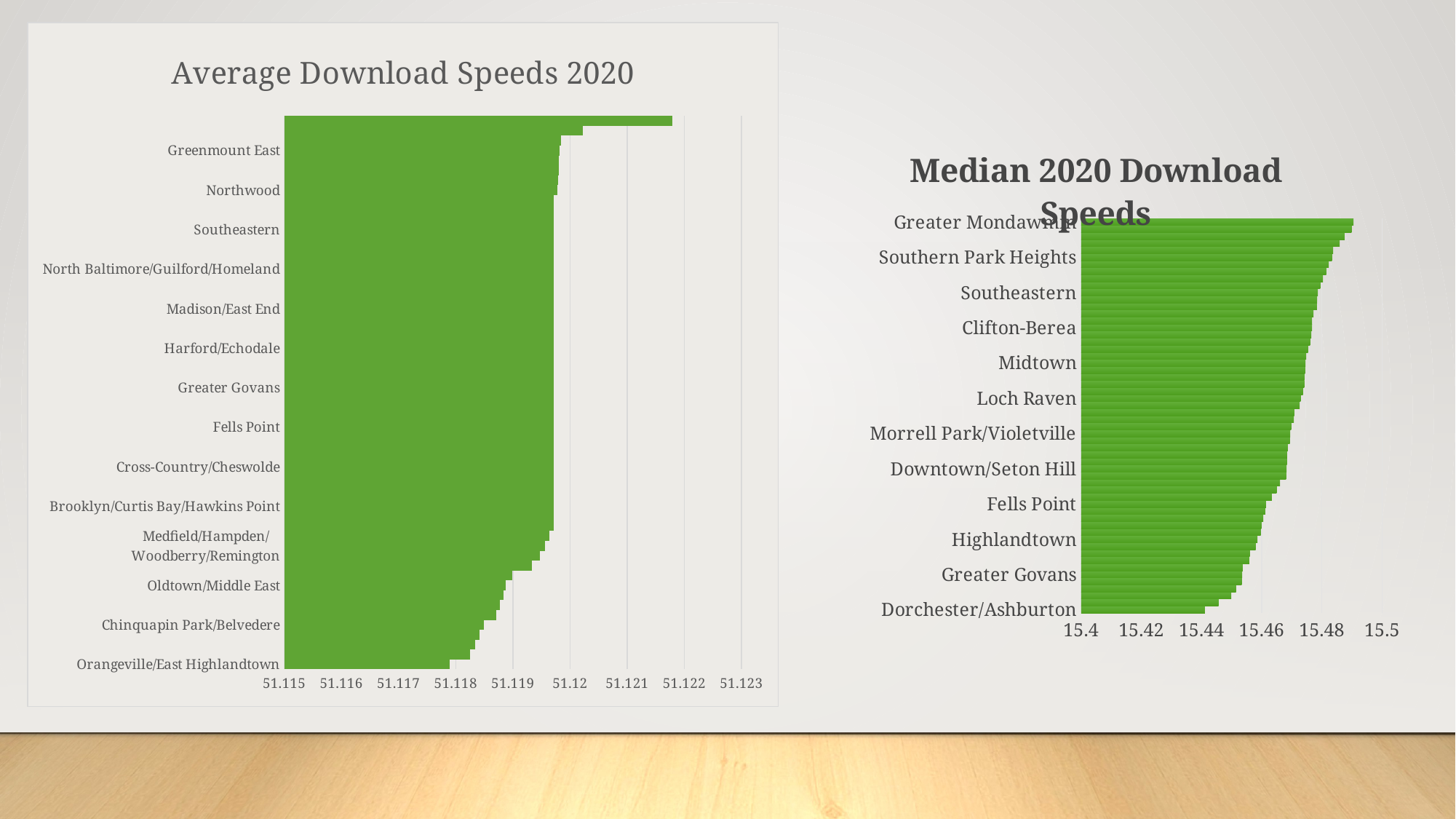
In the 'Median 2020 Download Speeds' chart, is the value for Loch Raven greater or less than 15.48? less In the 'Median 2020 Download Speeds' chart, is the value for Greater Govans greater or less than 15.46? less What kind of chart is the 'Median 2020 Download Speeds' chart on the right? bar chart In the 'Average Download Speeds 2020' chart, which labelled neighborhood has the lowest value? Orangeville/East Highlandtown What kind of chart is the 'Average Download Speeds 2020' chart on the left? bar chart In the 'Average Download Speeds 2020' chart, is the value for Chinquapin Park/Belvedere greater or less than 51.119? less In the 'Median 2020 Download Speeds' chart, which labelled neighborhood has the lowest value? Dorchester/Ashburton In the 'Median 2020 Download Speeds' chart, which is larger, the value for Greater Mondawmin or the value for Dorchester/Ashburton? Greater Mondawmin What is the title of the chart on the left of the slide? Average Download Speeds 2020 In the 'Median 2020 Download Speeds' chart, which labelled neighborhood has the highest value? Greater Mondawmin